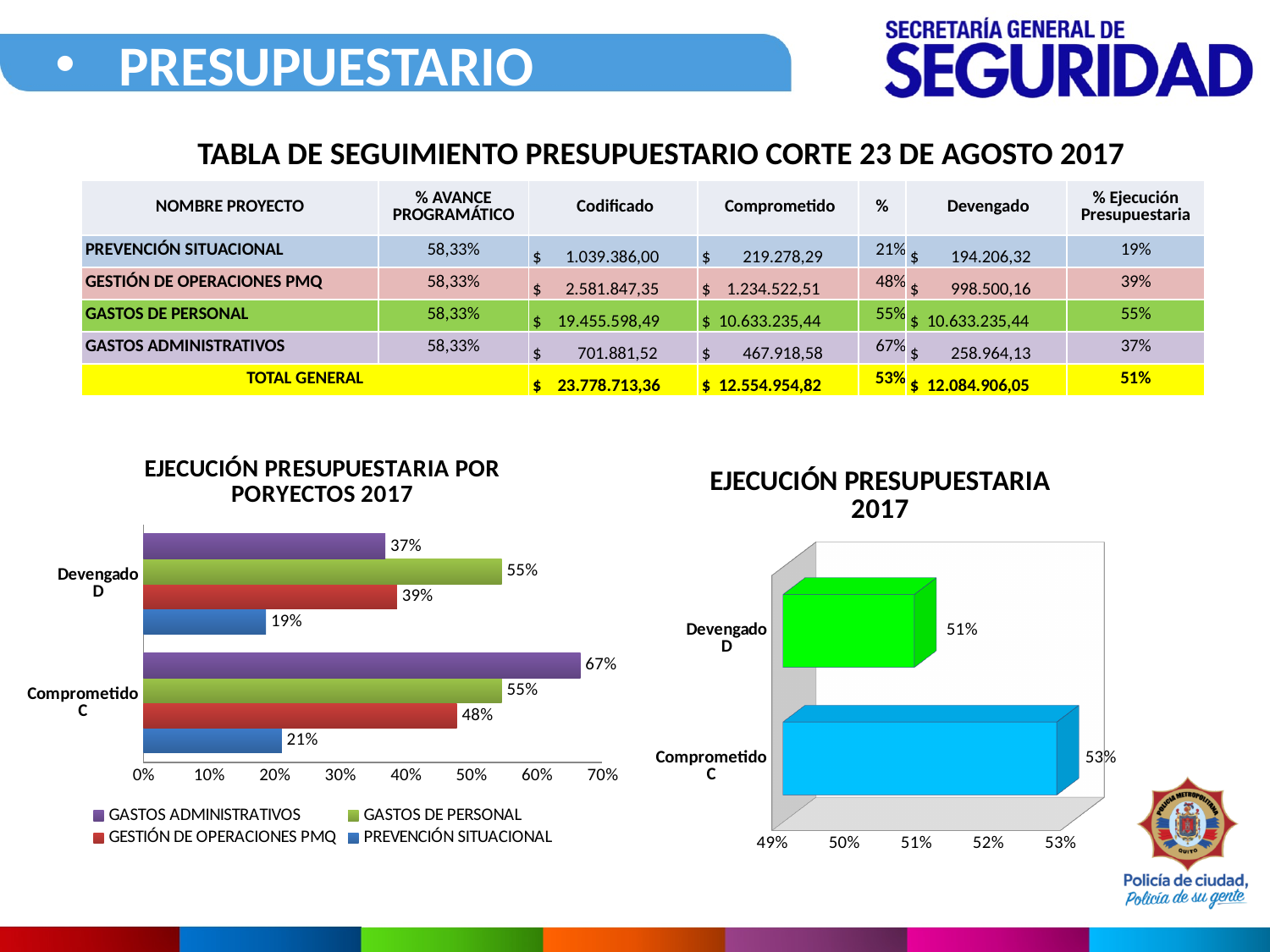
What kind of chart is the chart titled 'EJECUCIÓN PRESUPUESTARIA 2017'? Bar chart In the chart titled 'EJECUCIÓN PRESUPUESTARIA POR PORYECTOS 2017', what is the Devengado value for PREVENCIÓN SITUACIONAL? 19% In the chart titled 'EJECUCIÓN PRESUPUESTARIA POR PORYECTOS 2017', which series has the lowest Devengado value? PREVENCIÓN SITUACIONAL In the chart titled 'EJECUCIÓN PRESUPUESTARIA POR PORYECTOS 2017', which is larger for GESTIÓN DE OPERACIONES PMQ: the Comprometido value or the Devengado value? Comprometido In the chart titled 'EJECUCIÓN PRESUPUESTARIA POR PORYECTOS 2017', what is the difference between the Comprometido and Devengado values for GASTOS ADMINISTRATIVOS? 30% In the chart titled 'EJECUCIÓN PRESUPUESTARIA 2017', what is the difference between the Comprometido and Devengado values? 2% How many categories are shown in the chart titled 'EJECUCIÓN PRESUPUESTARIA 2017'? 2 In the chart titled 'EJECUCIÓN PRESUPUESTARIA POR PORYECTOS 2017', which series has the highest Comprometido value? GASTOS ADMINISTRATIVOS In the chart titled 'EJECUCIÓN PRESUPUESTARIA POR PORYECTOS 2017', what is the Comprometido value for GASTOS ADMINISTRATIVOS? 67% In the chart titled 'EJECUCIÓN PRESUPUESTARIA 2017', what is the value for Devengado? 51% In the chart titled 'EJECUCIÓN PRESUPUESTARIA POR PORYECTOS 2017', what is the Devengado value for GESTIÓN DE OPERACIONES PMQ? 39% How many series does the legend of the chart titled 'EJECUCIÓN PRESUPUESTARIA POR PORYECTOS 2017' list? 4